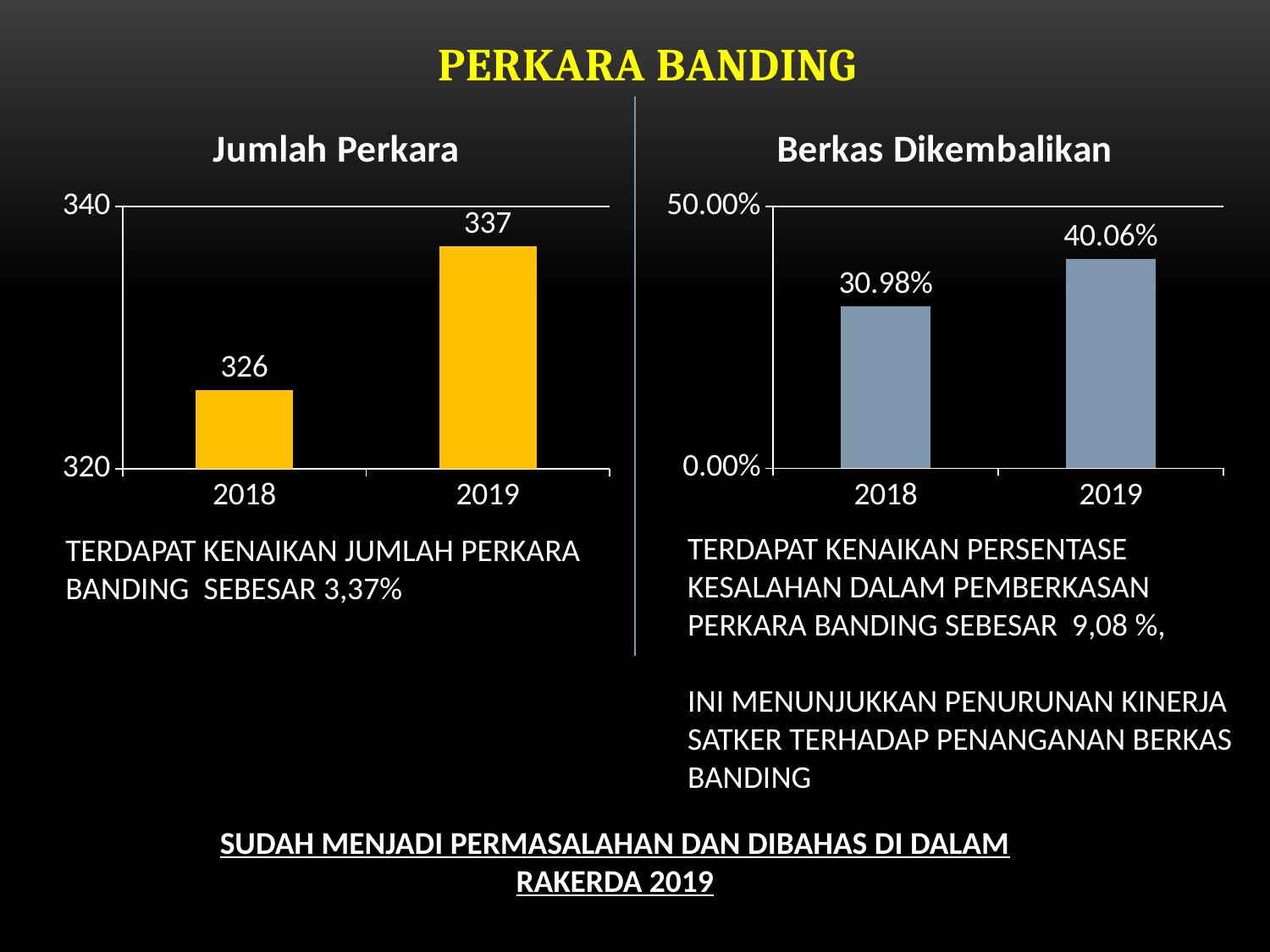
What kind of chart is the 'Berkas Dikembalikan' chart? bar chart In the 'Jumlah Perkara' chart, what is the difference between the 2019 and 2018 values? 11 In the 'Berkas Dikembalikan' chart, what is the difference between the 2019 and 2018 values? 9.08% How many categories are shown in the 'Jumlah Perkara' chart? 2 In the 'Jumlah Perkara' chart, what is the value for 2019? 337 In the 'Berkas Dikembalikan' chart, what is the value for 2018? 30.98% In the 'Berkas Dikembalikan' chart, what is the value for 2019? 40.06% In the 'Berkas Dikembalikan' chart, which year has the lower value? 2018 In the 'Berkas Dikembalikan' chart, is the value for 2019 greater or less than 30.98% for 2018? greater In the 'Jumlah Perkara' chart, what is the value for 2018? 326 In the 'Jumlah Perkara' chart, which year has the higher value? 2019 In the 'Jumlah Perkara' chart, do the values rise or fall from 2018 to 2019? rise